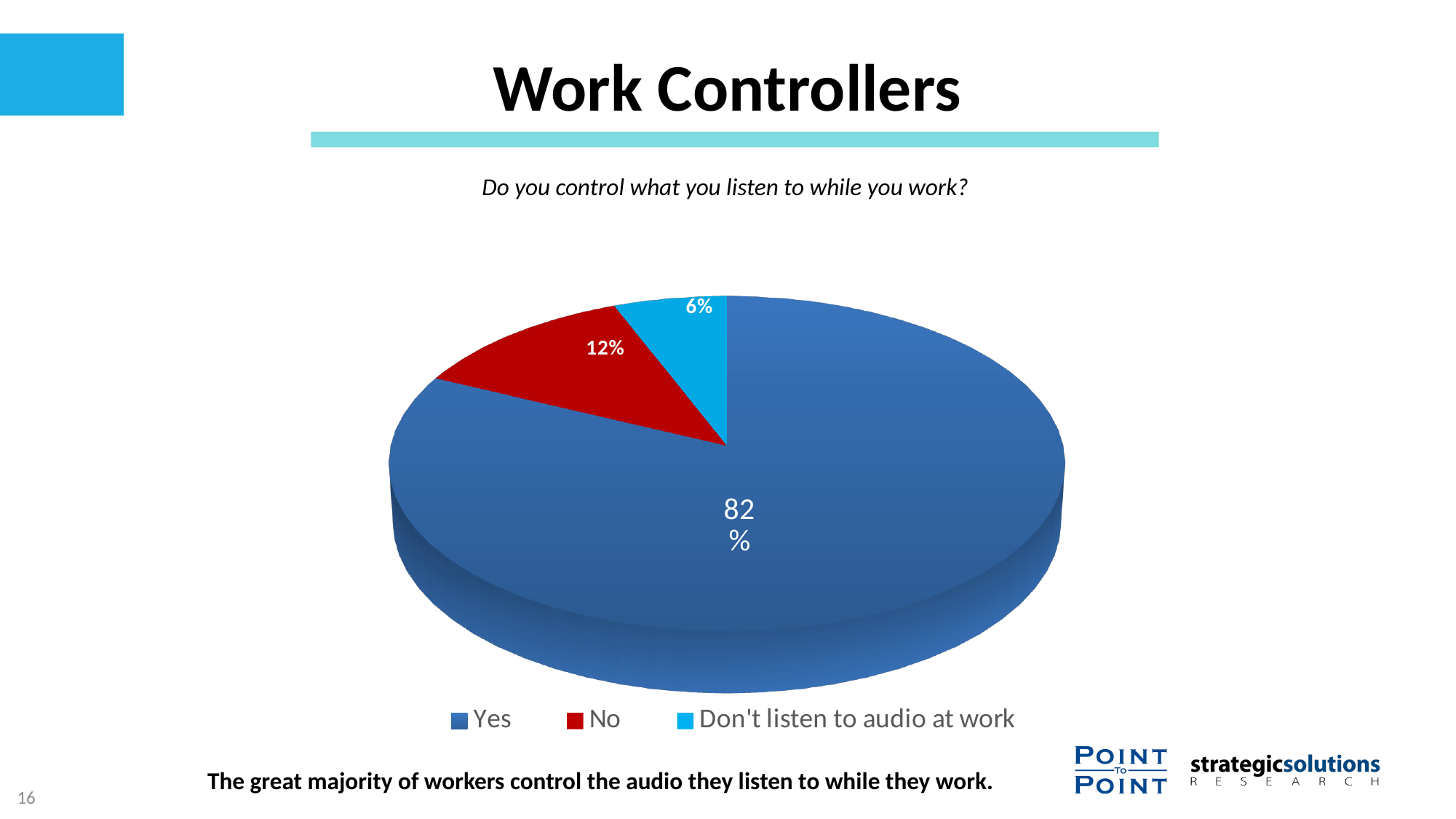
What is the difference in percentage points between the "No" slice and the "Don't listen to audio at work" slice? 6 What question does the chart's subtitle ask? Do you control what you listen to while you work? What share of respondents don't listen to audio at work? 6% What percentage of respondents answered "Yes" to controlling what they listen to while they work? 82% Which response has the smallest slice of the pie? Don't listen to audio at work Which is larger, the "No" slice or the "Don't listen to audio at work" slice? No How many categories does the pie chart show? 3 What percentage of respondents answered "No"? 12% What type of chart is shown on the slide? Pie chart What is the difference in percentage points between the "Yes" and "No" slices? 70 Which response has the largest slice of the pie? Yes What colour is the "No" slice in the pie chart? Red